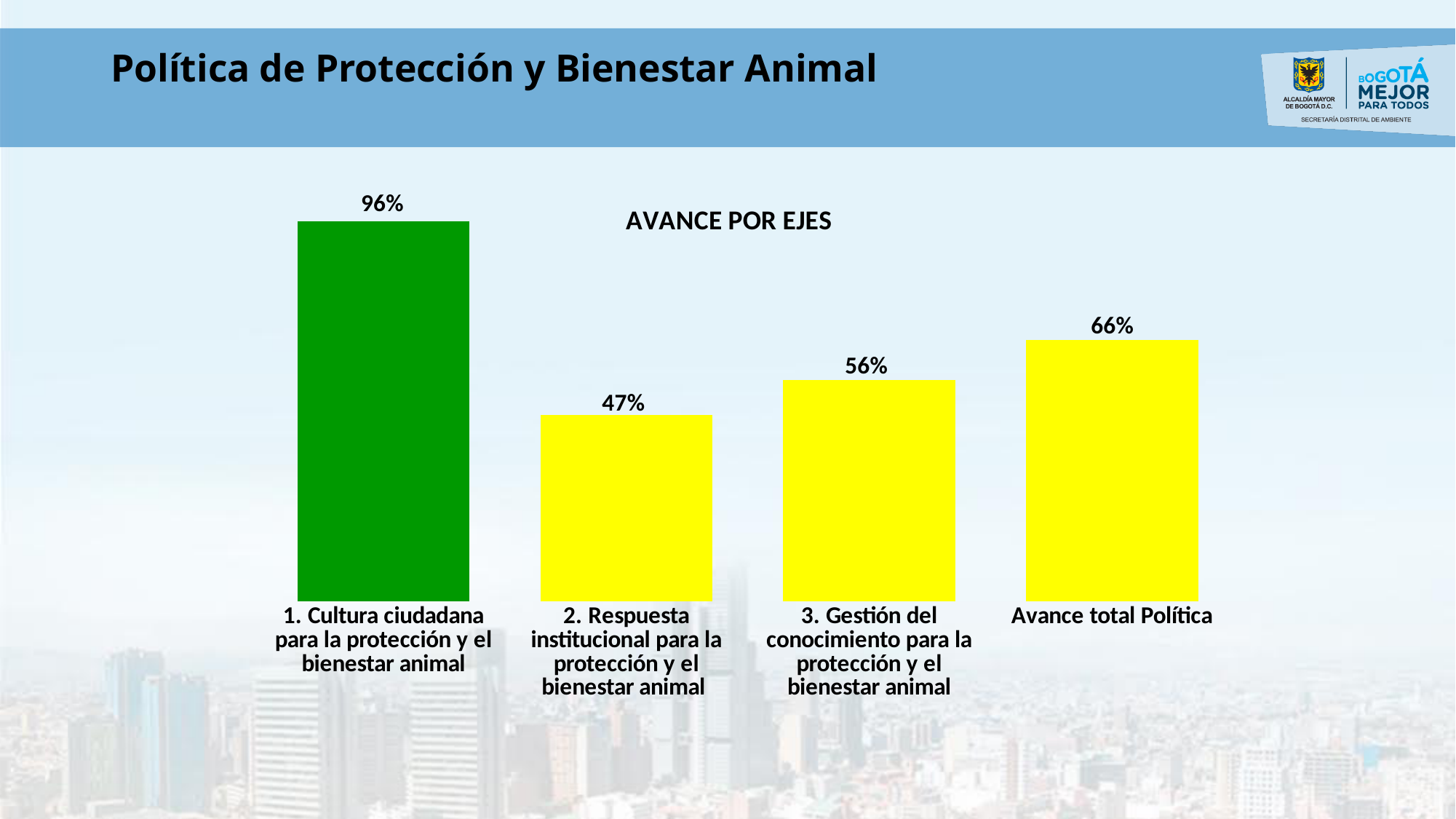
What kind of chart is shown on the slide? Bar chart How many bars are shown in the chart? 4 What is the value for 'Avance total Política'? 66% Which is larger, the value for '3. Gestión del conocimiento' or the value for 'Avance total Política'? Avance total Política What is the difference between 'Avance total Política' and '3. Gestión del conocimiento'? 10% What is the title of the chart? AVANCE POR EJES Which category has the highest value? 1. Cultura ciudadana para la protección y el bienestar animal What is the difference between the value for '1. Cultura ciudadana' and the value for '2. Respuesta institucional'? 49% Which category has the lowest value? 2. Respuesta institucional para la protección y el bienestar animal What is the value for '1. Cultura ciudadana para la protección y el bienestar animal'? 96% What is the value for '3. Gestión del conocimiento para la protección y el bienestar animal'? 56% What is the value for '2. Respuesta institucional para la protección y el bienestar animal'? 47%